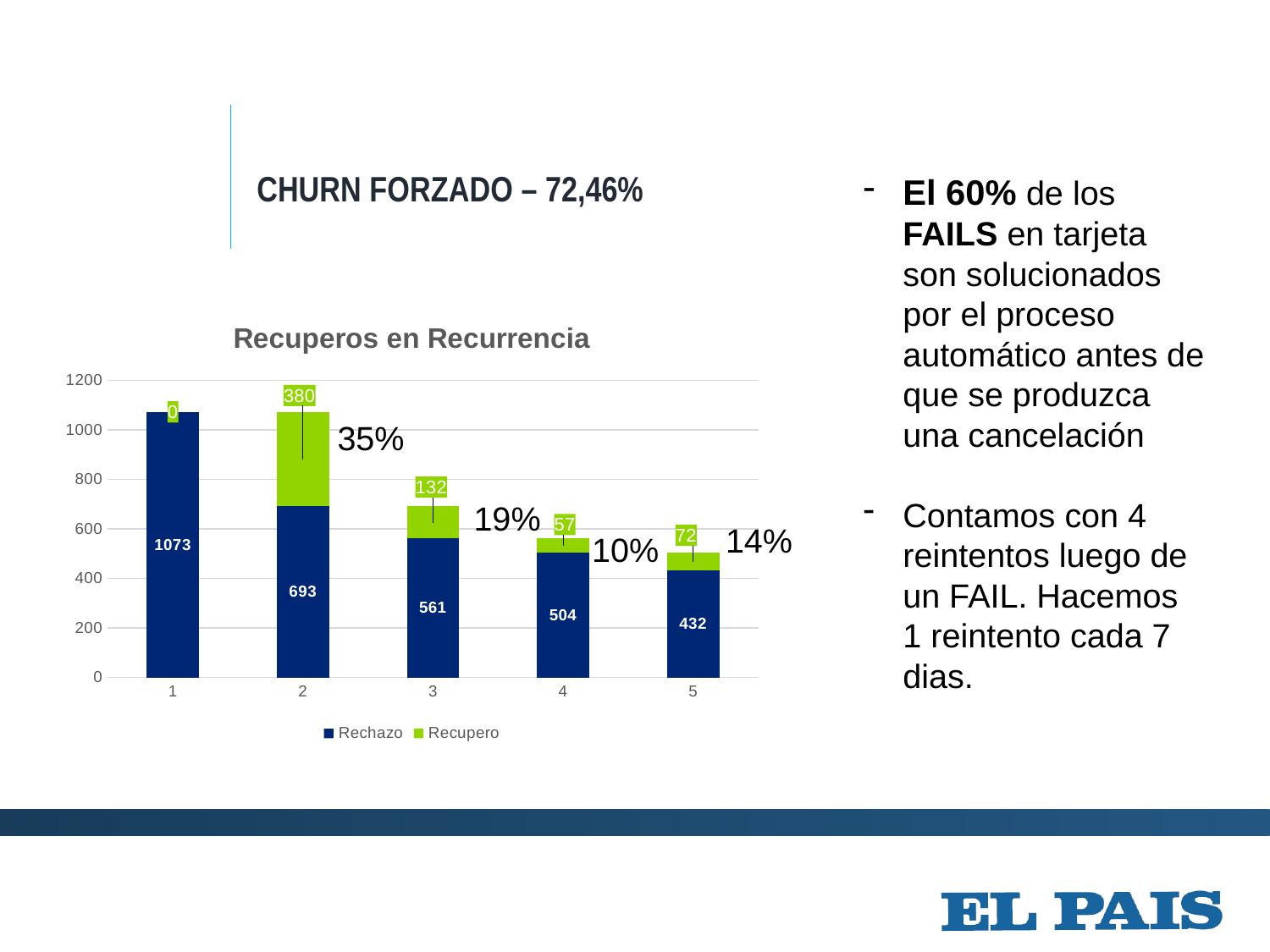
What is the Rechazo value for category 1? 1073 What is the Recupero value for category 4? 57 What is the Recupero value for category 2? 380 Which category has the lowest Recupero value? 1 What is the difference between the Rechazo values for categories 2 and 3? 132 How many categories are shown on the x axis? 5 What is the Rechazo value for category 5? 432 What kind of chart is shown? stacked bar chart How many series does the legend list? 2 Which category has the highest Rechazo value? 1 Which is larger, the Recupero value for category 4 or for category 5? category 5 What is the total of the stacked bar for category 2? 1073